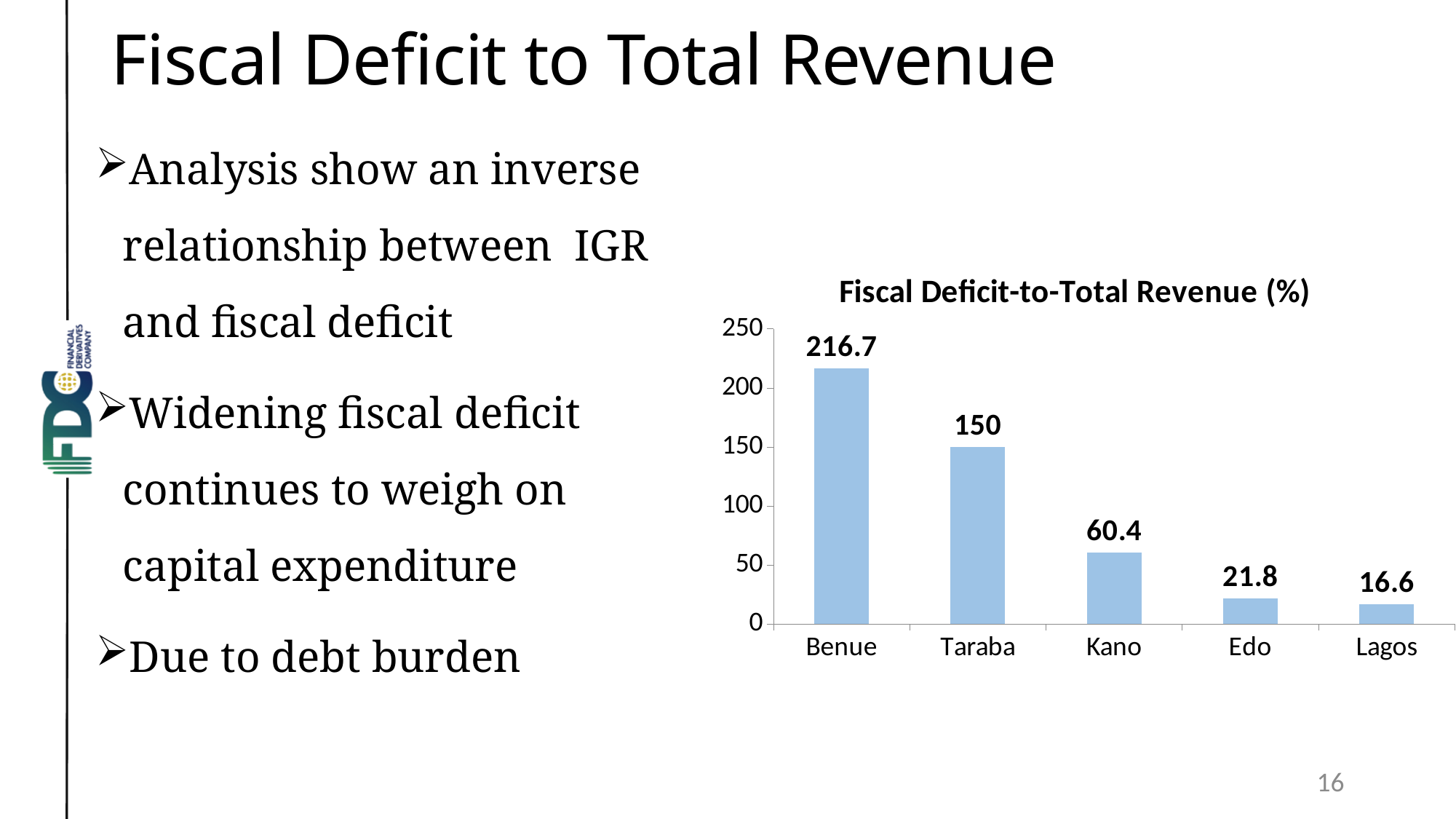
What is the fiscal deficit-to-total revenue value for Kano? 60.4 What is the fiscal deficit-to-total revenue value for Lagos? 16.6 What is the difference between the values for Edo and Lagos? 5.2 Is the value for Kano greater or less than 50? greater How many states are shown in the chart? 5 What is the title of the chart? Fiscal Deficit-to-Total Revenue (%) What is the difference between the values for Benue and Taraba? 66.7 Which state has the highest fiscal deficit-to-total revenue ratio? Benue What kind of chart is shown on the slide? Bar chart What is the fiscal deficit-to-total revenue value for Benue? 216.7 Which state has the lowest fiscal deficit-to-total revenue ratio? Lagos Which is larger, the value for Taraba or the value for Kano? Taraba